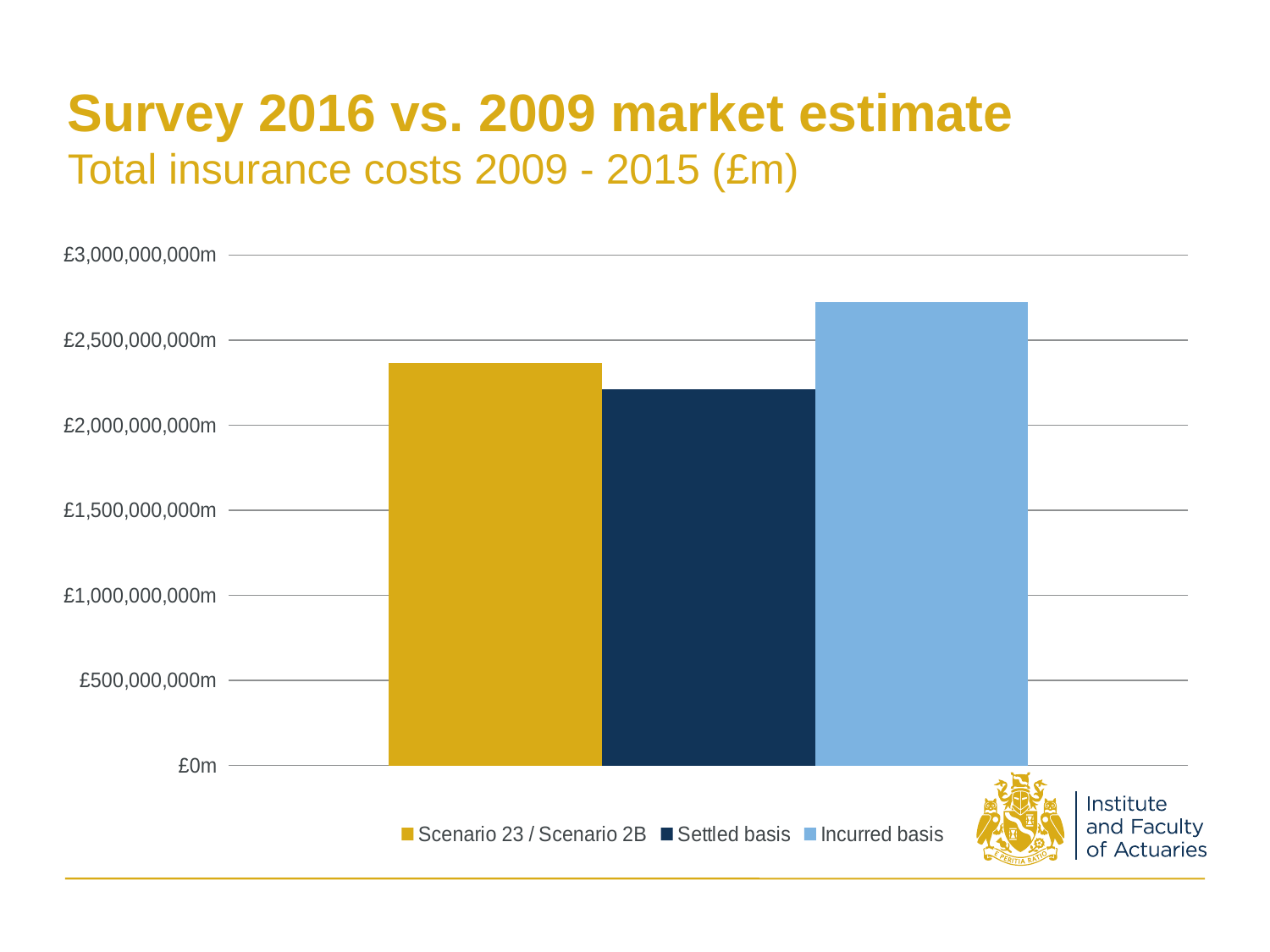
What is the subtitle of the chart shown on the slide? Total insurance costs 2009 - 2015 (£m) Which is larger, the value for Incurred basis or the value for Settled basis? Incurred basis How many series does the legend list? 3 How many bars are plotted in the chart? 3 Which series has the highest value? Incurred basis Is the value for Settled basis greater or less than £2,000,000,000m? greater Which series is shown in the gold/yellow colour in the legend? Scenario 23 / Scenario 2B Which series has the lowest value? Settled basis Is the value for Incurred basis greater or less than £2,500,000,000m? greater What kind of chart is shown on the slide? bar chart Is the value for Scenario 23 / Scenario 2B greater or less than £2,500,000,000m? less Which is larger, the value for Scenario 23 / Scenario 2B or the value for Settled basis? Scenario 23 / Scenario 2B